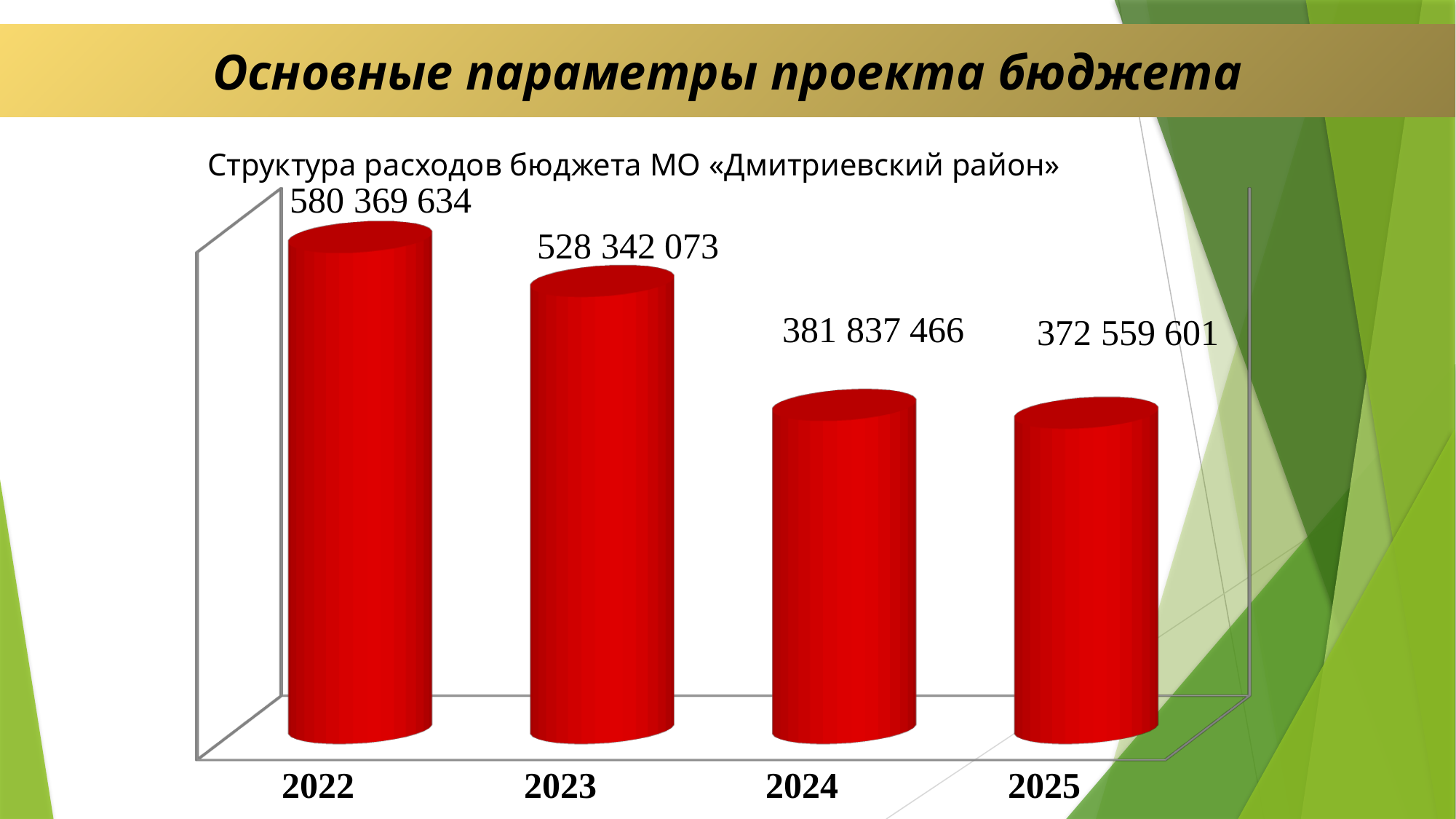
Which year has the lowest value? 2025 What is the value for 2023? 528 342 073 What is the difference between the values for 2024 and 2025? 9 277 865 What is the value for 2022? 580 369 634 What is the difference between the values for 2022 and 2023? 52 027 561 What is the value for 2025? 372 559 601 Which is larger, the value for 2023 or the value for 2024? 2023 How many years are shown on the chart? 4 Which year has the highest value? 2022 What is the value for 2024? 381 837 466 What kind of chart is shown on the slide? Bar chart Do the values rise or fall from 2022 to 2025? Fall